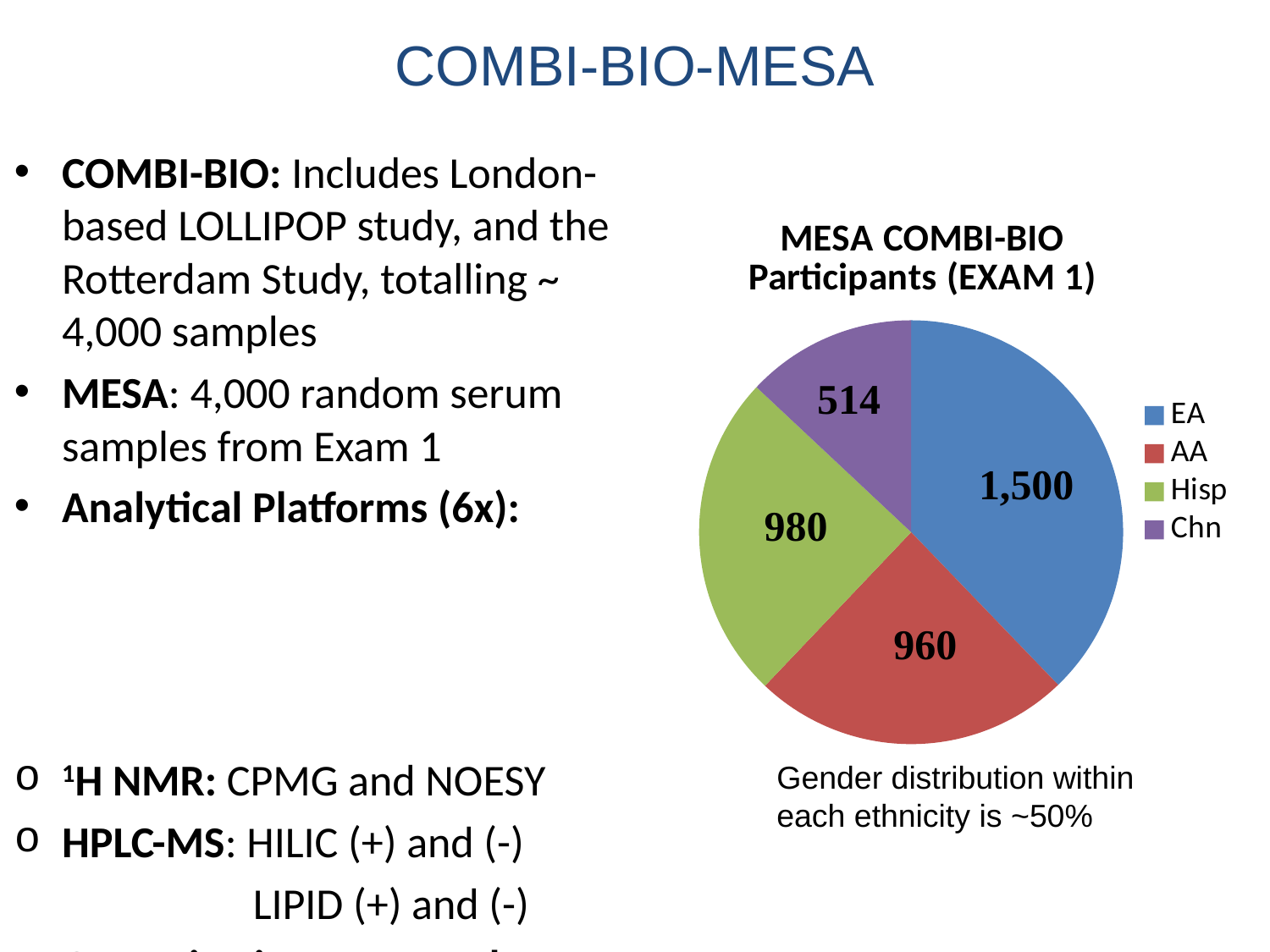
What is the difference between the EA and AA values in the pie chart? 540 What value is shown for the Hisp slice of the pie chart? 980 How many categories does the legend of the pie chart list? 4 Which ethnicity group has the largest slice in the pie chart? EA Which ethnicity group has the smallest slice in the pie chart? Chn What type of chart is shown on the slide? pie chart Which is larger in the pie chart, the EA value or the Chn value? EA What colour is the AA slice in the pie chart? red What is the difference between the Hisp and AA values in the pie chart? 20 What value is shown for the Chn slice of the pie chart? 514 What is the title of the chart? MESA COMBI-BIO Participants (EXAM 1) How many participants are in the EA slice of the pie chart? 1,500